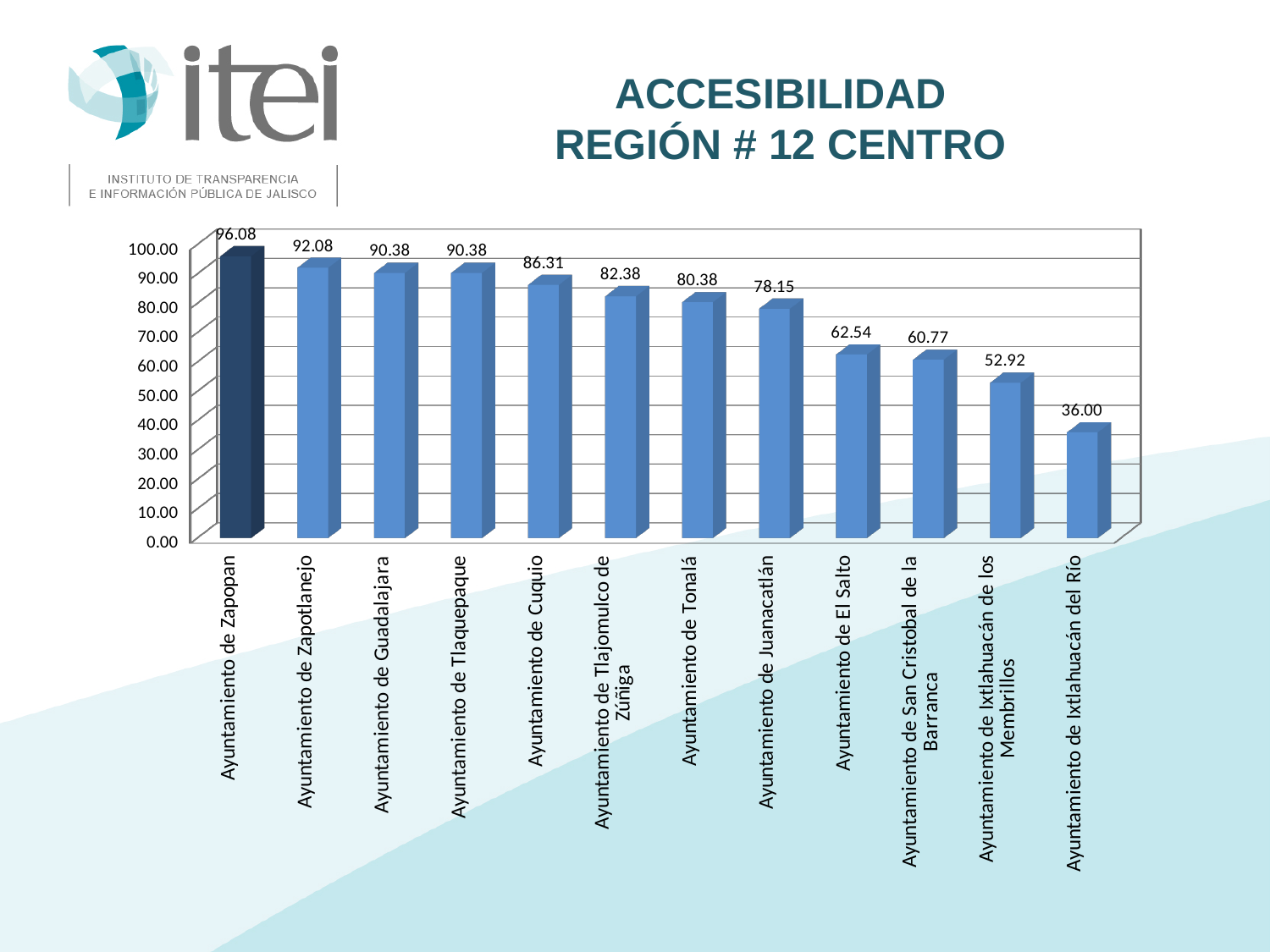
What is the value for Ayuntamiento de Zapopan? 96.08 What is the difference between the values for Ayuntamiento de Tonalá and Ayuntamiento de Juanacatlán? 2.23 Do the values rise or fall from left to right along the x axis? fall How many categories are shown in the chart? 12 Which category has the lowest value? Ayuntamiento de Ixtlahuacán del Río What kind of chart is shown on the slide? bar chart Which category has the highest value? Ayuntamiento de Zapopan What is the value for Ayuntamiento de Cuquio? 86.31 What is the value for Ayuntamiento de El Salto? 62.54 Is the value for Ayuntamiento de Ixtlahuacán de los Membrillos greater or less than 60.00? less What is the difference between the values for Ayuntamiento de Zapopan and Ayuntamiento de Ixtlahuacán del Río? 60.08 Which is larger, the value for Ayuntamiento de Zapotlanejo or the value for Ayuntamiento de Tlajomulco de Zúñiga? Ayuntamiento de Zapotlanejo